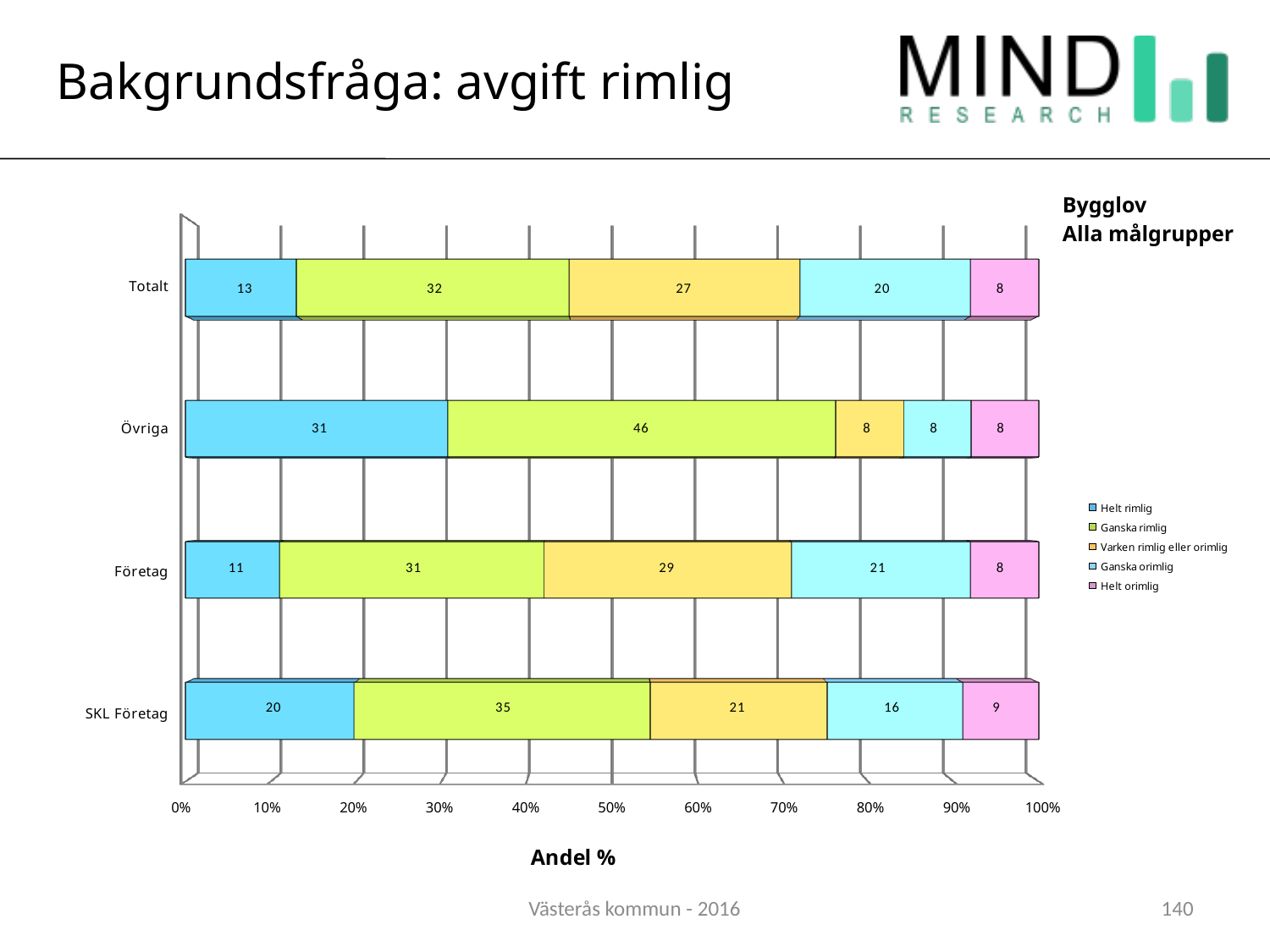
What kind of chart is shown on the slide? Stacked bar chart What is the value for "Ganska rimlig" in the Övriga bar? 46 What is the value for "Varken rimlig eller orimlig" in the Företag bar? 29 Which category has the highest value for "Helt rimlig"? Övriga How many series does the legend list? 5 What is the label of the x axis? Andel % Which category has the lowest value for "Ganska orimlig"? Övriga What is the difference between the "Ganska rimlig" values for Övriga and Företag? 15 What is the value for "Helt orimlig" in the SKL Företag bar? 9 How many categories are shown on the y axis? 4 What is the value for "Helt rimlig" in the Totalt bar? 13 Which is larger: the "Helt rimlig" value for SKL Företag or for Företag? SKL Företag